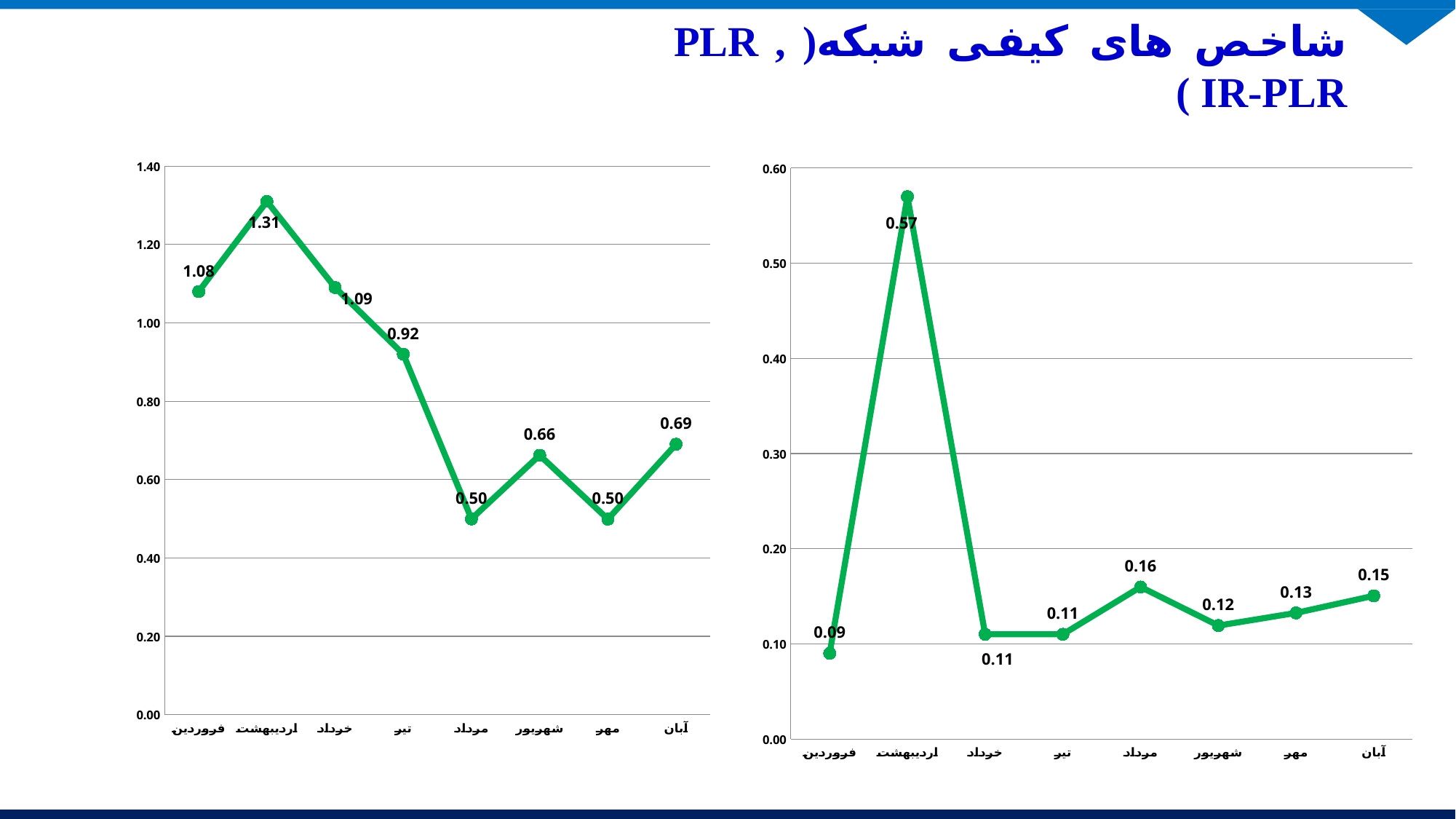
In the right chart, what is the value for مرداد? 0.16 In the right chart, what is the difference between the values for اردیبهشت and فروردین? 0.48 In the left chart, which month has the highest value? اردیبهشت In the right chart, what is the value for آبان? 0.15 What kind of chart is the left chart? line chart In the right chart, which month has the lowest value? فروردین How many data points are plotted in the right chart? 8 In the left chart, what is the value for اردیبهشت? 1.31 In the right chart, which month has the highest value? اردیبهشت In the left chart, what is the difference between the values for اردیبهشت and مرداد? 0.81 In the left chart, what is the value for تیر? 0.92 In the left chart, which is larger, the value for شهریور or the value for آبان? آبان